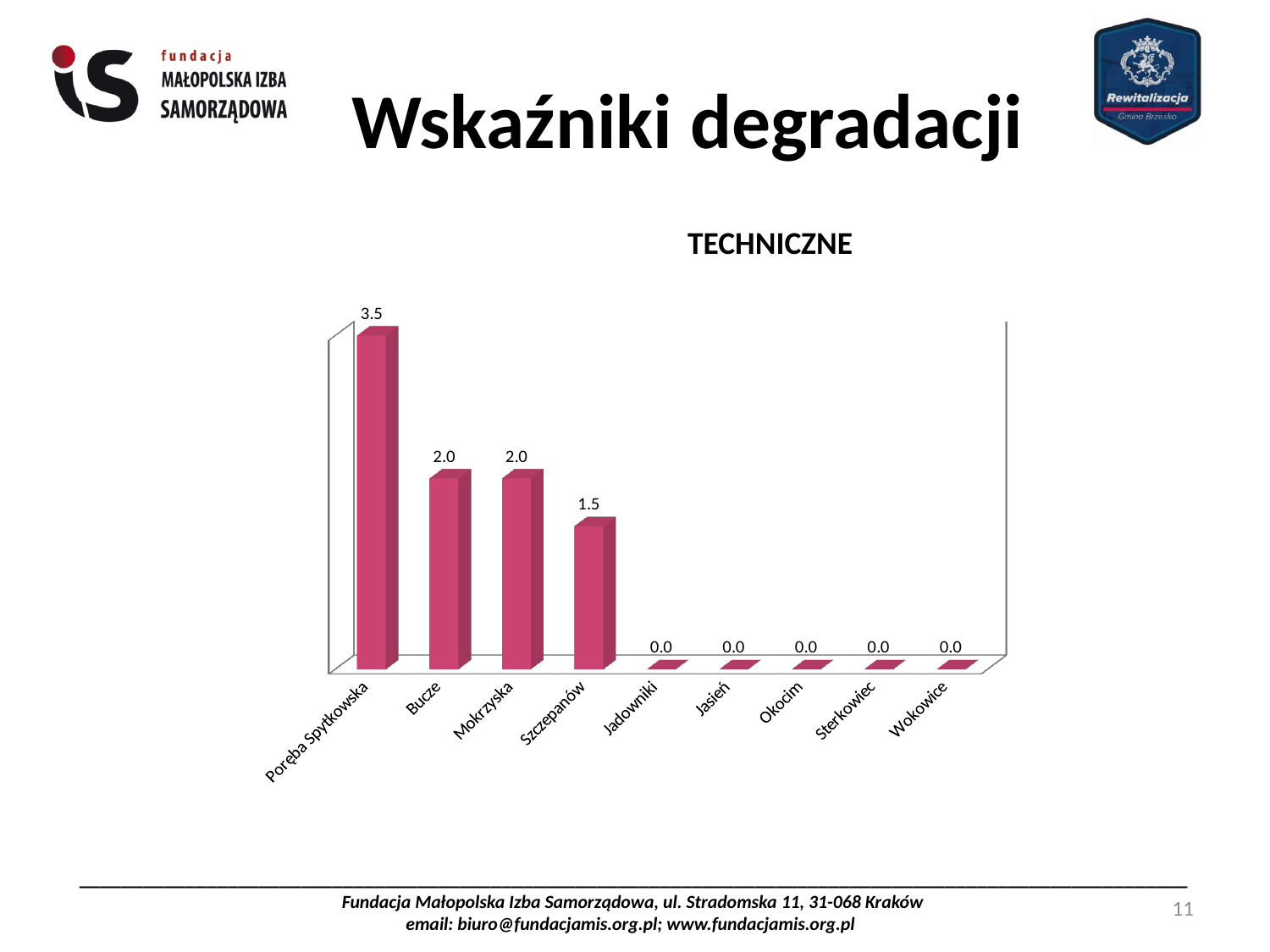
What is the value for Poręba Spytkowska in the TECHNICZNE chart? 3.5 How many categories are shown on the x axis of the TECHNICZNE chart? 9 How many categories in the TECHNICZNE chart have a value of 0.0? 5 What is the difference between the values for Poręba Spytkowska and Szczepanów? 2.0 What is the value for Jadowniki in the TECHNICZNE chart? 0.0 Which is larger, the value for Mokrzyska or the value for Szczepanów? Mokrzyska Which category has the highest value in the TECHNICZNE chart? Poręba Spytkowska What is the difference between the values for Bucze and Szczepanów? 0.5 What kind of chart is shown on the slide? Bar chart What is the value for Bucze in the TECHNICZNE chart? 2.0 What is the value for Szczepanów in the TECHNICZNE chart? 1.5 What is the title of the chart on the slide? TECHNICZNE